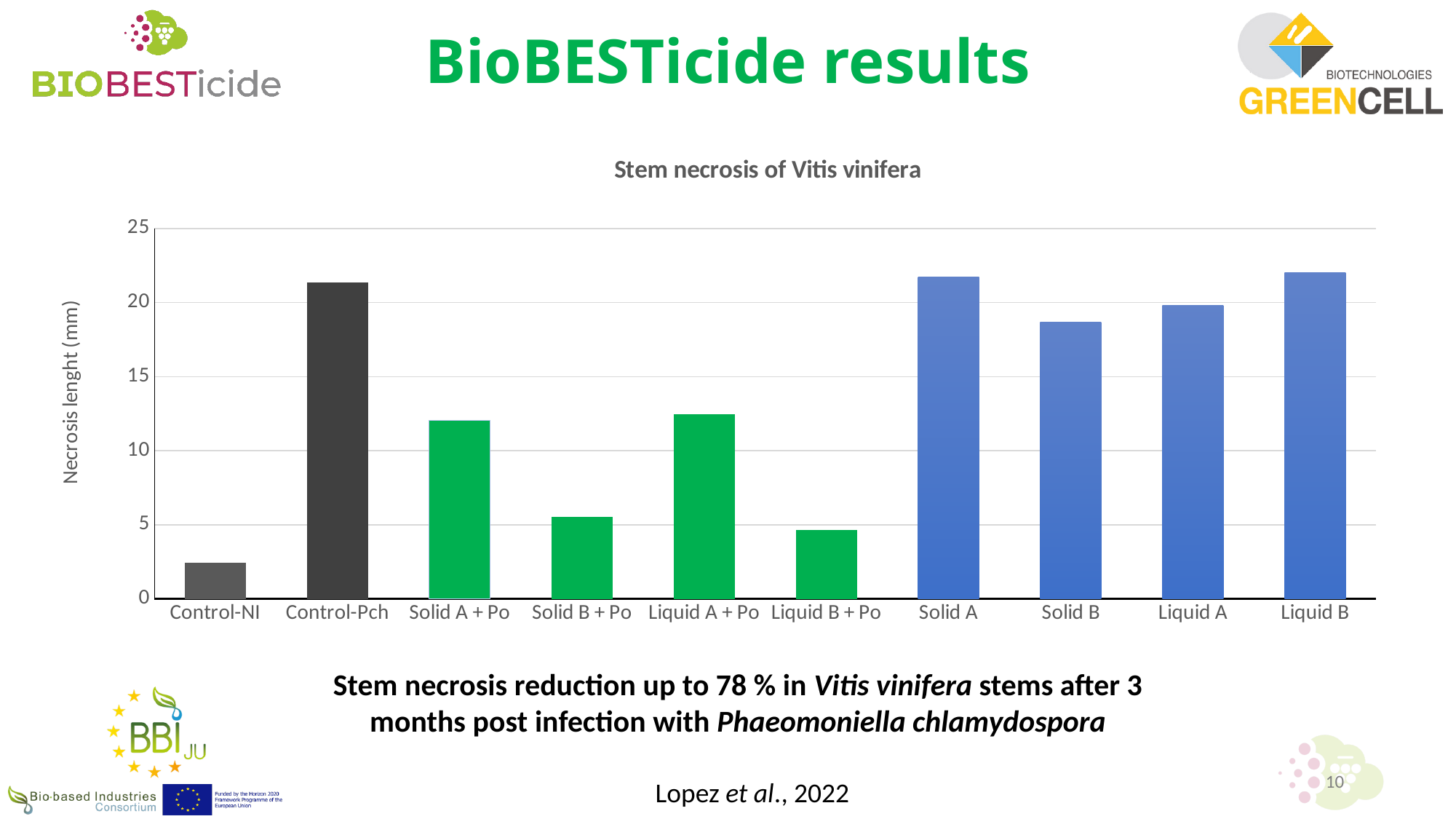
Is the value for Control-Pch greater or less than 20? greater Which category has the lowest necrosis length? Control-NI Which has a larger necrosis length, Liquid A + Po or Solid B + Po? Liquid A + Po Which has a larger necrosis length, Control-Pch or Control-NI? Control-Pch Is the value for Liquid B + Po greater or less than 5? less Is the value for Solid B greater or less than 20? less What is the title of the chart? Stem necrosis of Vitis vinifera What is the label of the vertical axis? Necrosis lenght (mm) How many categories are shown on the x axis? 10 What kind of chart is shown on the slide? bar chart